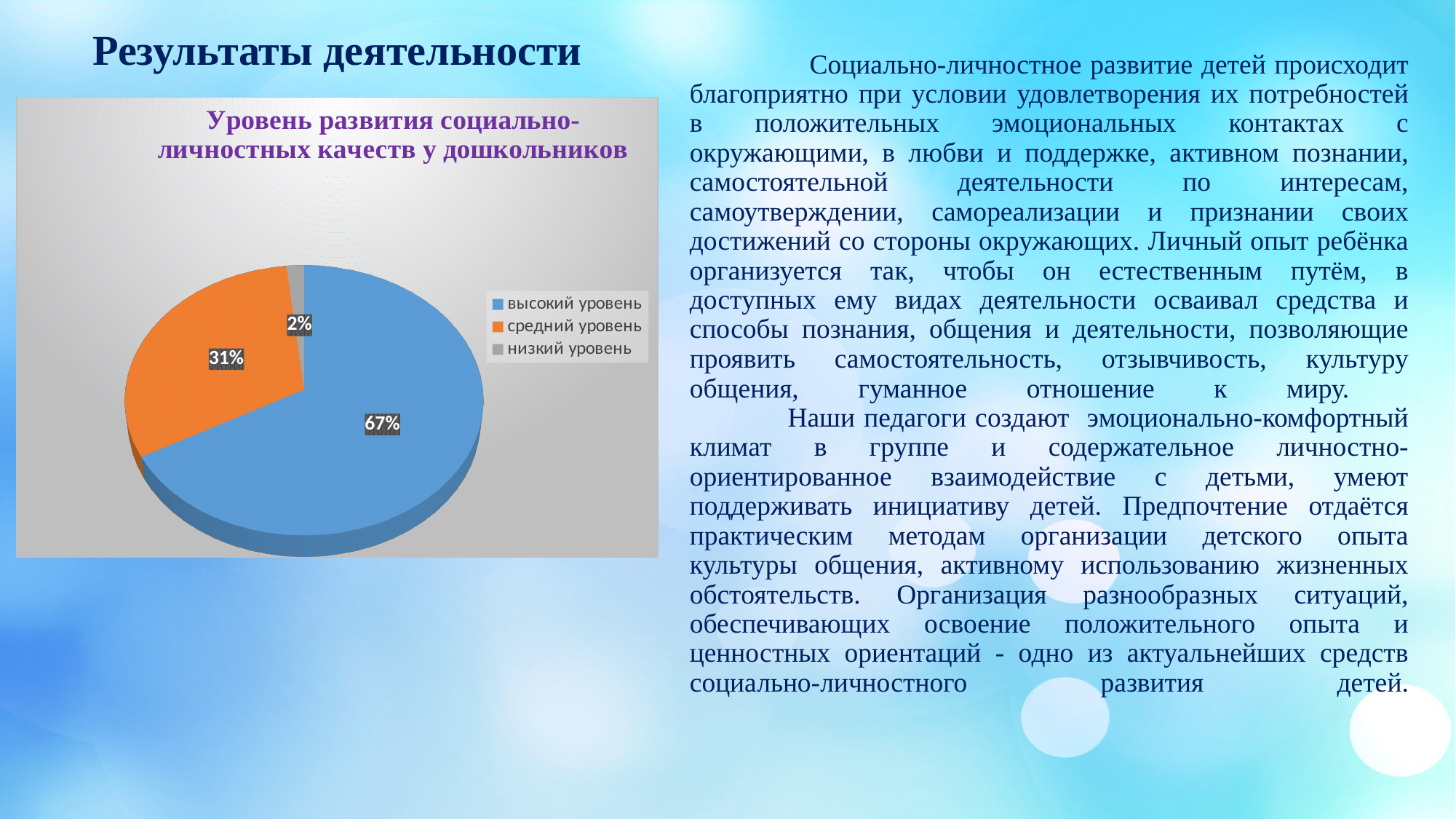
Which slice is larger: "средний уровень" or "низкий уровень"? средний уровень What share of the pie is labelled "высокий уровень"? 67% Which category has the largest slice of the pie? высокий уровень How many categories does the pie chart show? 3 What is the title of the chart? Уровень развития социально-личностных качеств у дошкольников What share of the pie is labelled "низкий уровень"? 2% What colour is the "средний уровень" slice? orange What share of the pie is labelled "средний уровень"? 31% Which category has the smallest slice of the pie? низкий уровень What is the difference in percentage points between the "высокий уровень" and "средний уровень" slices? 36 What kind of chart is shown on the slide? pie chart